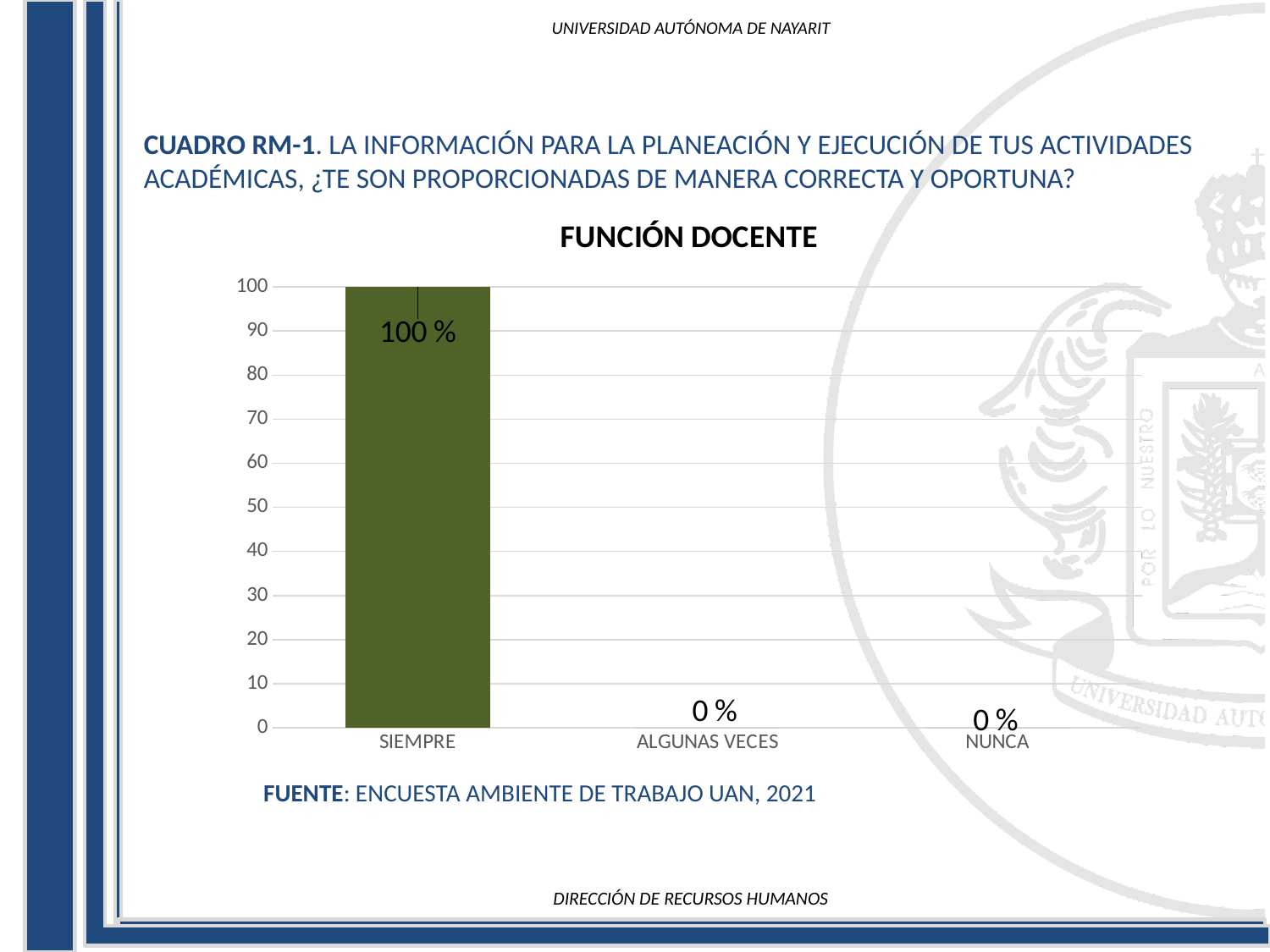
What is the value for ALGUNAS VECES? 0 % How many categories are shown on the x axis? 3 What is the title of the chart? FUNCIÓN DOCENTE Which category has the highest value? SIEMPRE What is the difference between the values for SIEMPRE and ALGUNAS VECES? 100 % What kind of chart is shown? bar chart What is the value for SIEMPRE? 100 % What is the maximum value shown on the y axis? 100 Which is larger, the value for SIEMPRE or the value for NUNCA? SIEMPRE What is the value for NUNCA? 0 % Is the value for SIEMPRE greater or less than 50? greater